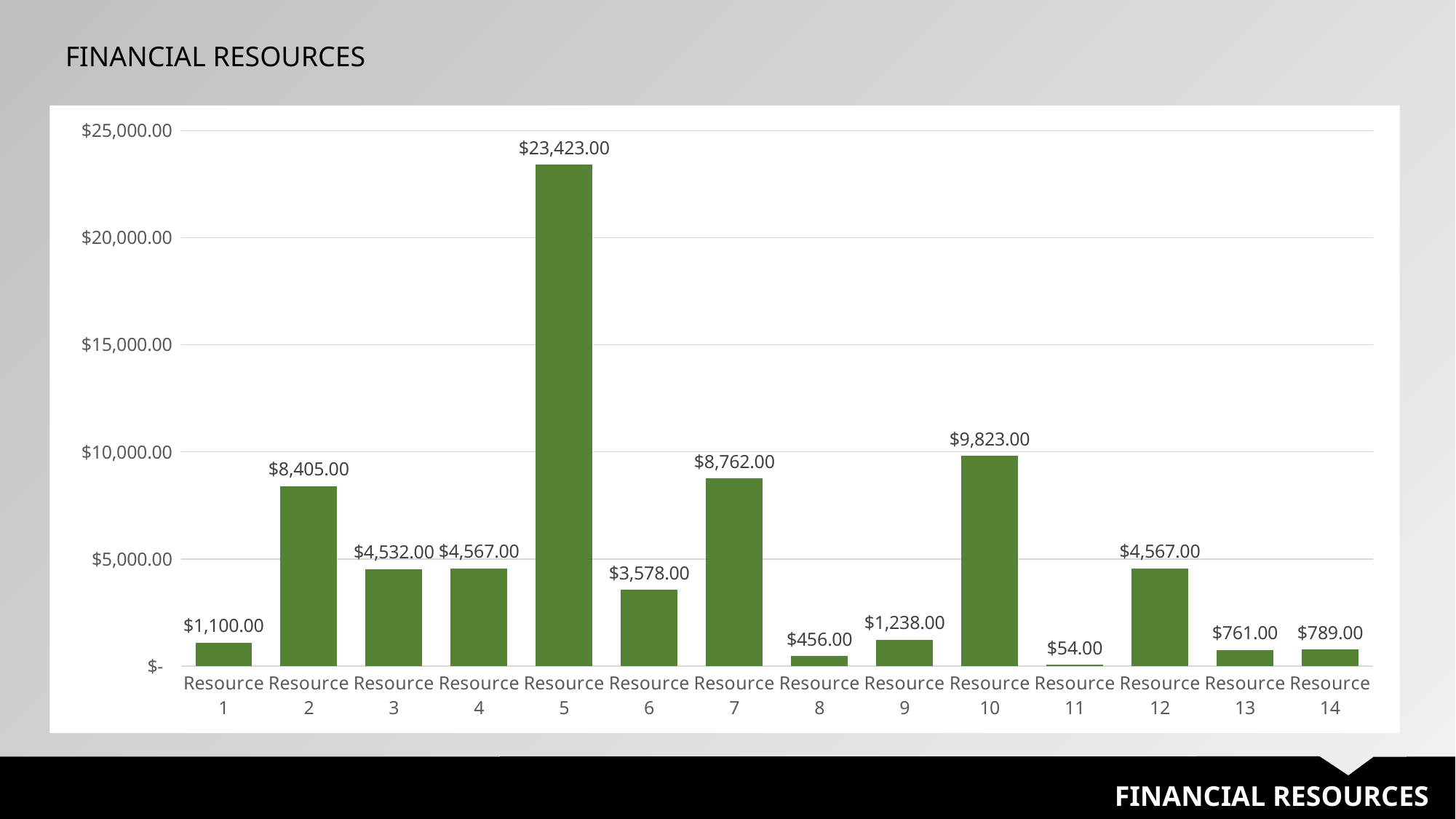
Which resource has the highest value? Resource 5 What kind of chart is shown on the slide? Bar chart Is the value for Resource 10 greater or less than $5,000.00? greater Which is larger, the value for Resource 6 or the value for Resource 3? Resource 3 What is the difference between the values for Resource 2 and Resource 7? $357.00 What is the value for Resource 10? $9,823.00 How many resources are shown on the chart? 14 What is the difference between the values for Resource 14 and Resource 13? $28.00 What is the value for Resource 5? $23,423.00 What is the value for Resource 11? $54.00 Which resource has the lowest value? Resource 11 What is the title of the slide? FINANCIAL RESOURCES